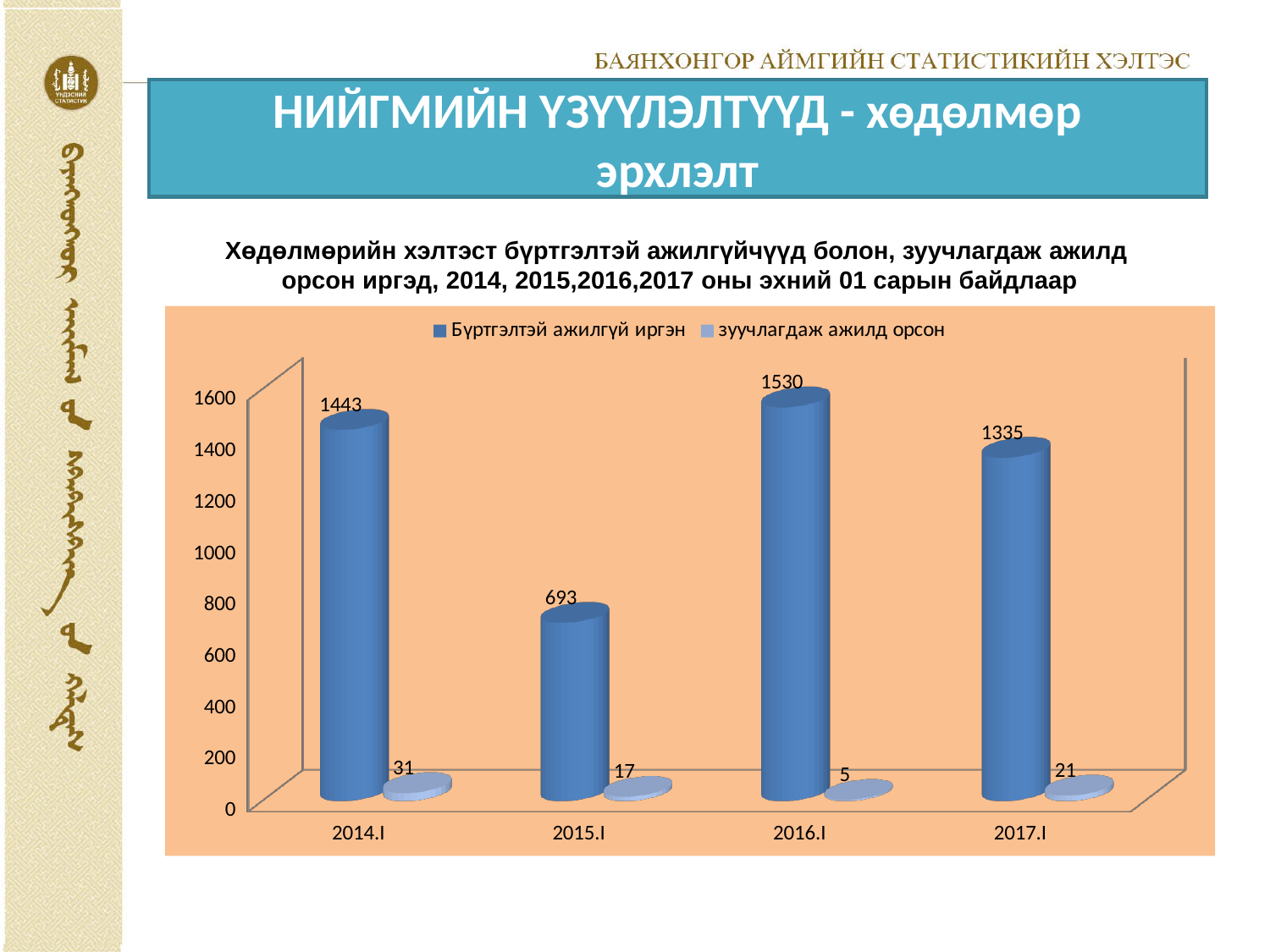
Is the value for 'Бүртгэлтэй ажилгүй иргэн' in 2015.I greater or less than 800? less Which year has the lowest value for 'зуучлагдаж ажилд орсон'? 2016.I How many years are shown on the x axis? 4 What is the value for 'зуучлагдаж ажилд орсон' in 2014.I? 31 What is the name of the second series in the legend? зуучлагдаж ажилд орсон What is the difference between the 'Бүртгэлтэй ажилгүй иргэн' values for 2014.I and 2017.I? 108 How many series does the legend list? 2 What kind of chart is shown on the slide? bar chart Which year has the highest value for 'Бүртгэлтэй ажилгүй иргэн'? 2016.I Which is larger: 'зуучлагдаж ажилд орсон' in 2015.I or in 2017.I? 2017.I What is the value for 'Бүртгэлтэй ажилгүй иргэн' in 2016.I? 1530 What is the value for 'Бүртгэлтэй ажилгүй иргэн' in 2015.I? 693